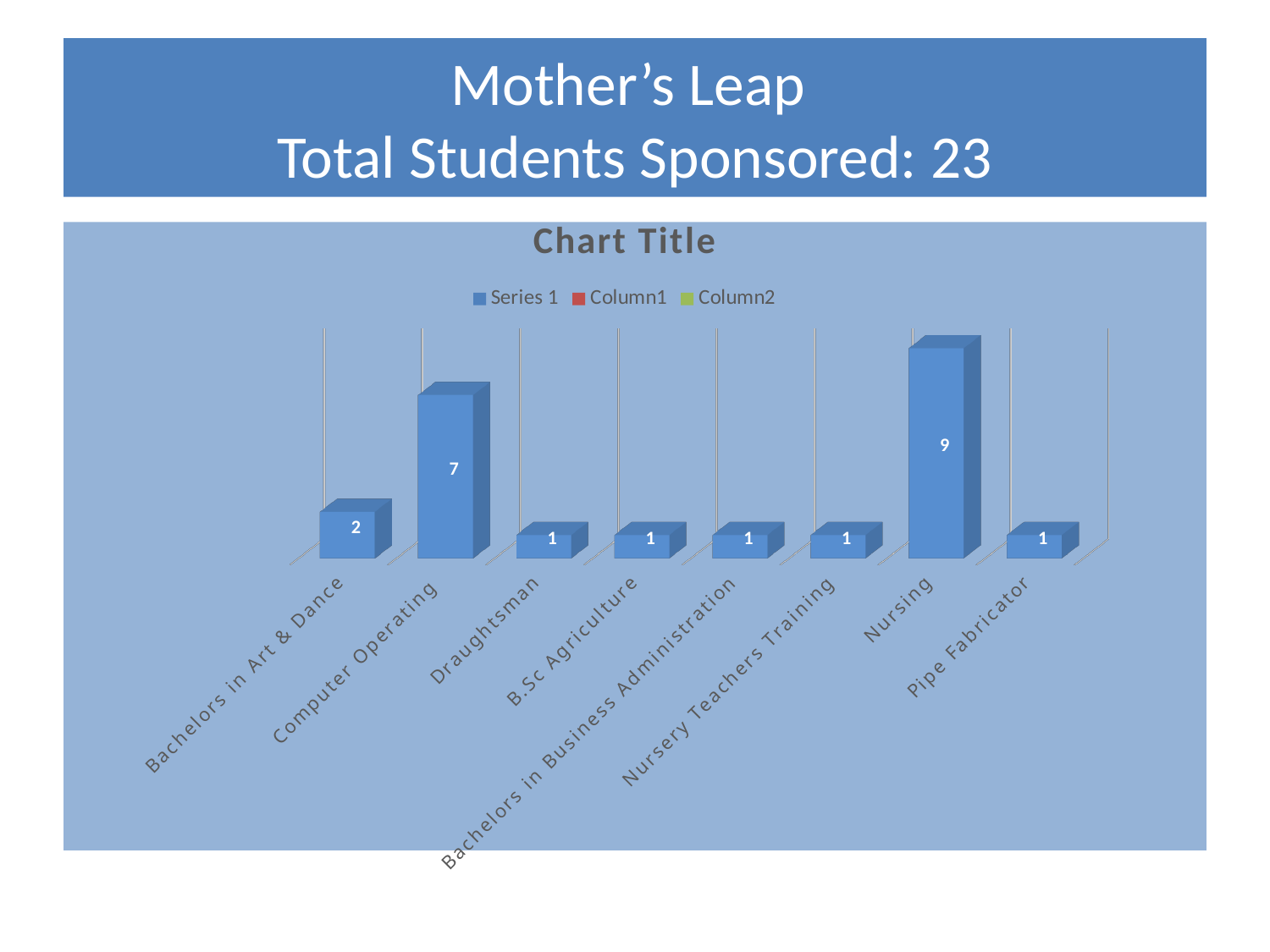
What is the difference between the values for Computer Operating and Bachelors in Art & Dance? 5 What is the value for Computer Operating? 7 How many series does the legend list? 3 What is the difference between the values for Nursing and Computer Operating? 2 What is the value for Bachelors in Art & Dance? 2 How many categories are shown on the x axis? 8 Which category has the highest value? Nursing Which is larger, the value for Bachelors in Art & Dance or the value for Draughtsman? Bachelors in Art & Dance What is the value for Nursing? 9 What is the value for Pipe Fabricator? 1 What is the title shown above the chart? Chart Title What kind of chart is shown? Bar chart